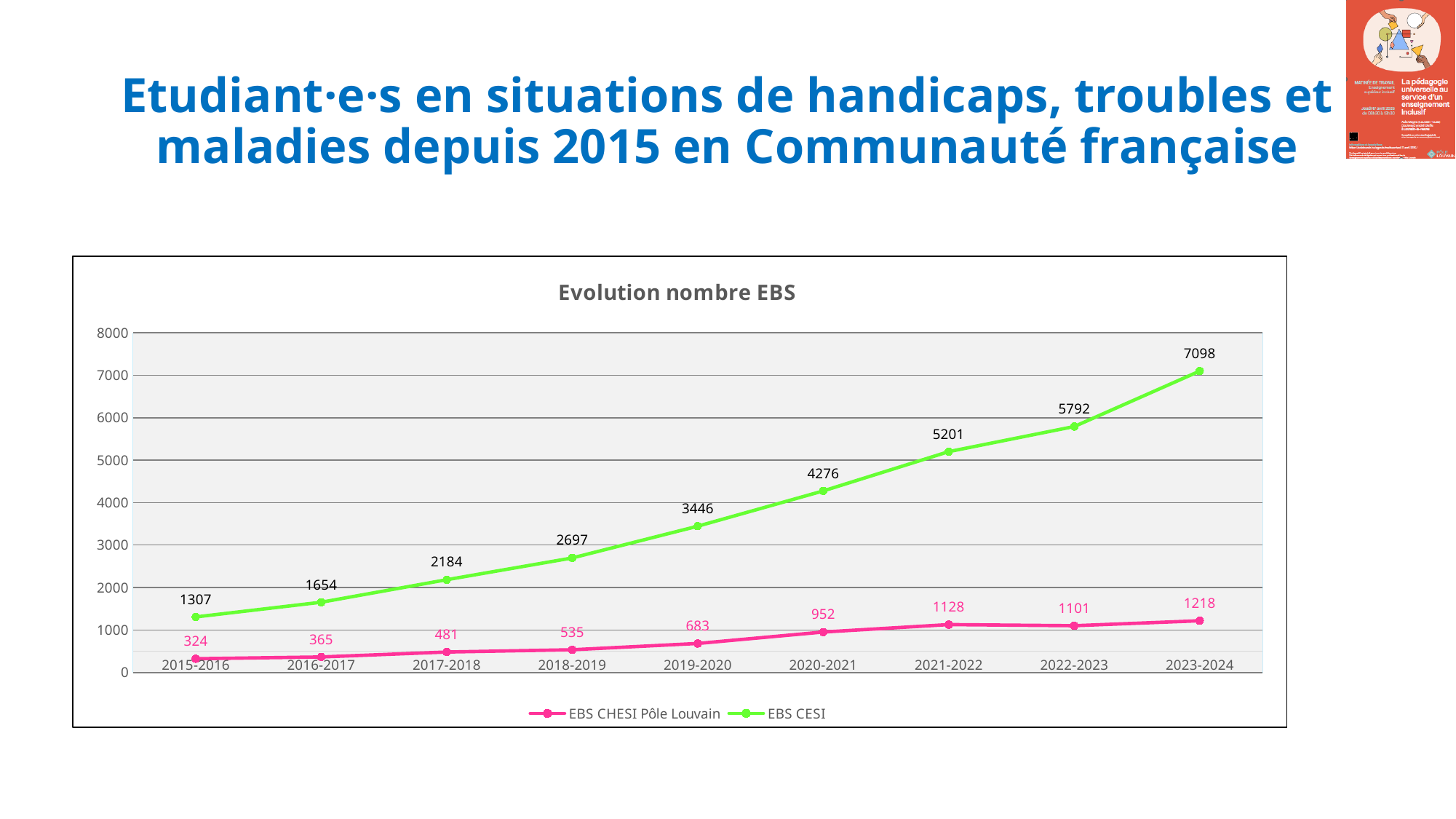
What is the title of the chart? Evolution nombre EBS In which academic year is the EBS CESI value lowest? 2015-2016 In which academic year is the EBS CHESI Pôle Louvain value highest? 2023-2024 What kind of chart is shown on the slide? Line chart Do the EBS CESI values rise or fall from 2015-2016 to 2023-2024? Rise Which series has the larger value in 2018-2019, EBS CESI or EBS CHESI Pôle Louvain? EBS CESI How many series does the legend list? 2 What is the difference between EBS CESI and EBS CHESI Pôle Louvain in 2021-2022? 4073 What is the value for EBS CHESI Pôle Louvain in 2019-2020? 683 What is the value for EBS CESI in 2023-2024? 7098 How many academic years are shown on the x axis? 9 What is the value for EBS CESI in 2017-2018? 2184